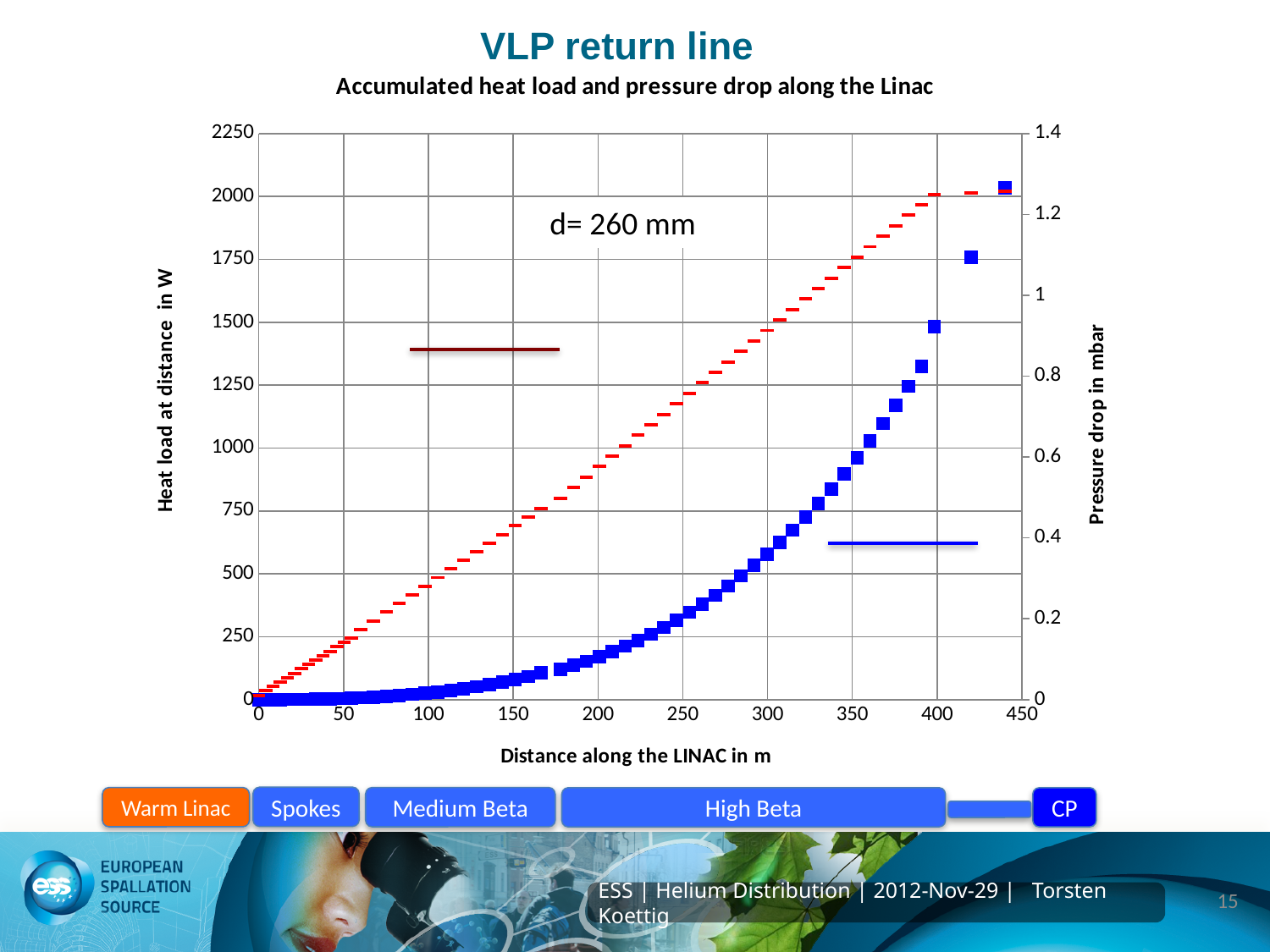
Is the pressure drop (blue series) at a distance of 300 m greater or less than 0.2 mbar? greater At which end of the distance axis does the heat load (red series) reach its highest value? the right end (around 440 m) Is the heat load (red series) at a distance of 150 m greater or less than 750 W? less Is the pressure drop (blue series) at a distance of 200 m greater or less than 0.2 mbar? less How many data series are plotted on the chart? 2 Does the heat load (red series) rise or fall as the distance along the LINAC increases? rise What pipe diameter is annotated on the chart? d= 260 mm Does the pressure drop (blue series) rise or fall as the distance along the LINAC increases? rise What type of chart is shown on the slide? scatter chart What is the title of the chart? Accumulated heat load and pressure drop along the Linac